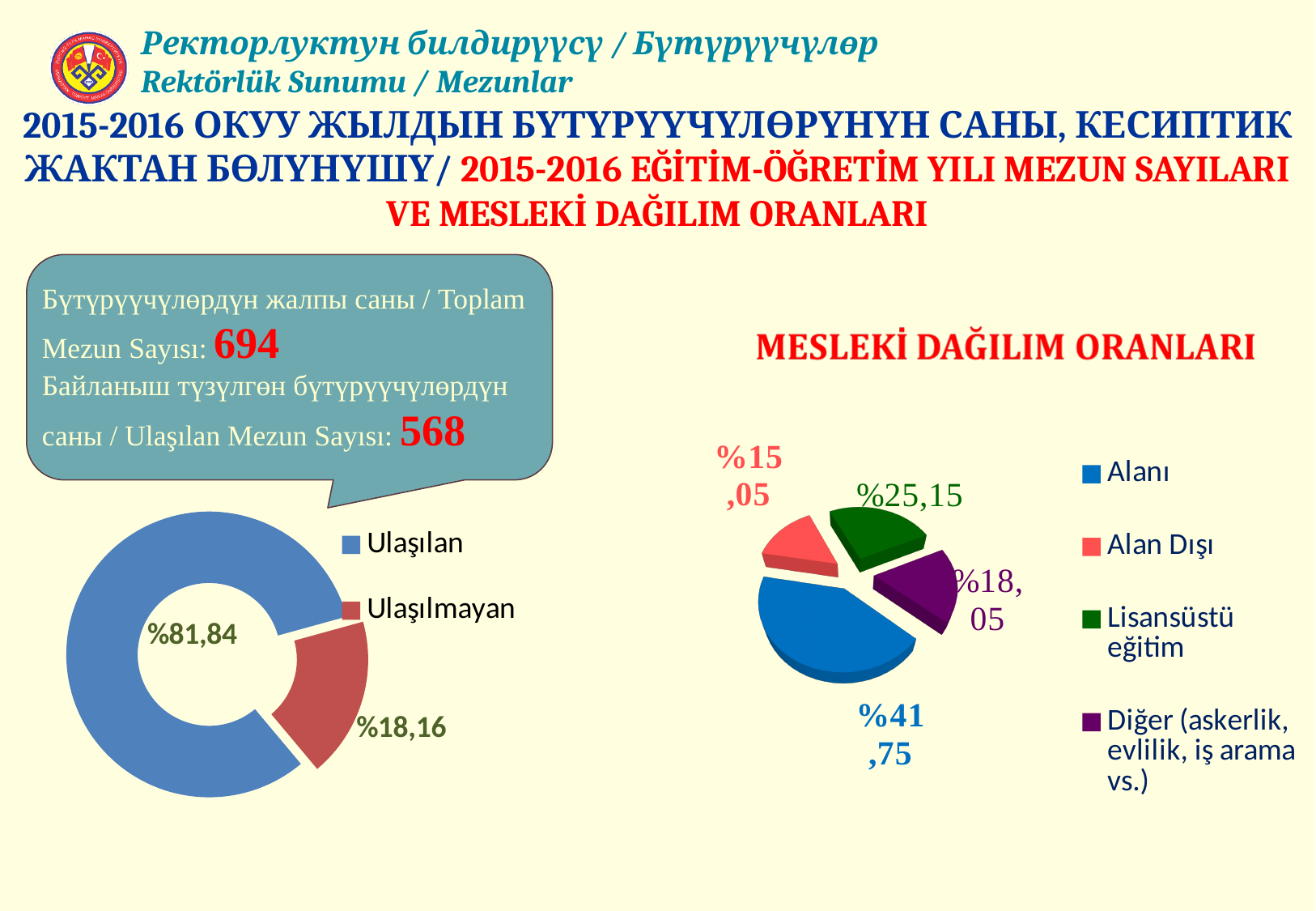
In the doughnut chart on the left, which category has the larger share? Ulaşılan In the doughnut chart on the left, how many categories does the legend list? 2 In the MESLEKİ DAĞILIM ORANLARI chart, what is the value for Alan Dışı? %15,05 In the doughnut chart on the left, what is the value for Ulaşılmayan? %18,16 In the MESLEKİ DAĞILIM ORANLARI chart, what is the value for Diğer (askerlik, evlilik, iş arama vs.)? %18,05 In the MESLEKİ DAĞILIM ORANLARI chart, which is larger, Lisansüstü eğitim or Diğer (askerlik, evlilik, iş arama vs.)? Lisansüstü eğitim What kind of chart is the chart on the left of the slide? Doughnut chart In the doughnut chart on the left, what is the value for Ulaşılan? %81,84 In the MESLEKİ DAĞILIM ORANLARI chart, which category has the smallest share? Alan Dışı In the MESLEKİ DAĞILIM ORANLARI chart, how many categories does the legend list? 4 In the MESLEKİ DAĞILIM ORANLARI chart, what is the value for Alanı? %41,75 In the MESLEKİ DAĞILIM ORANLARI chart, what is the value for Lisansüstü eğitim? %25,15